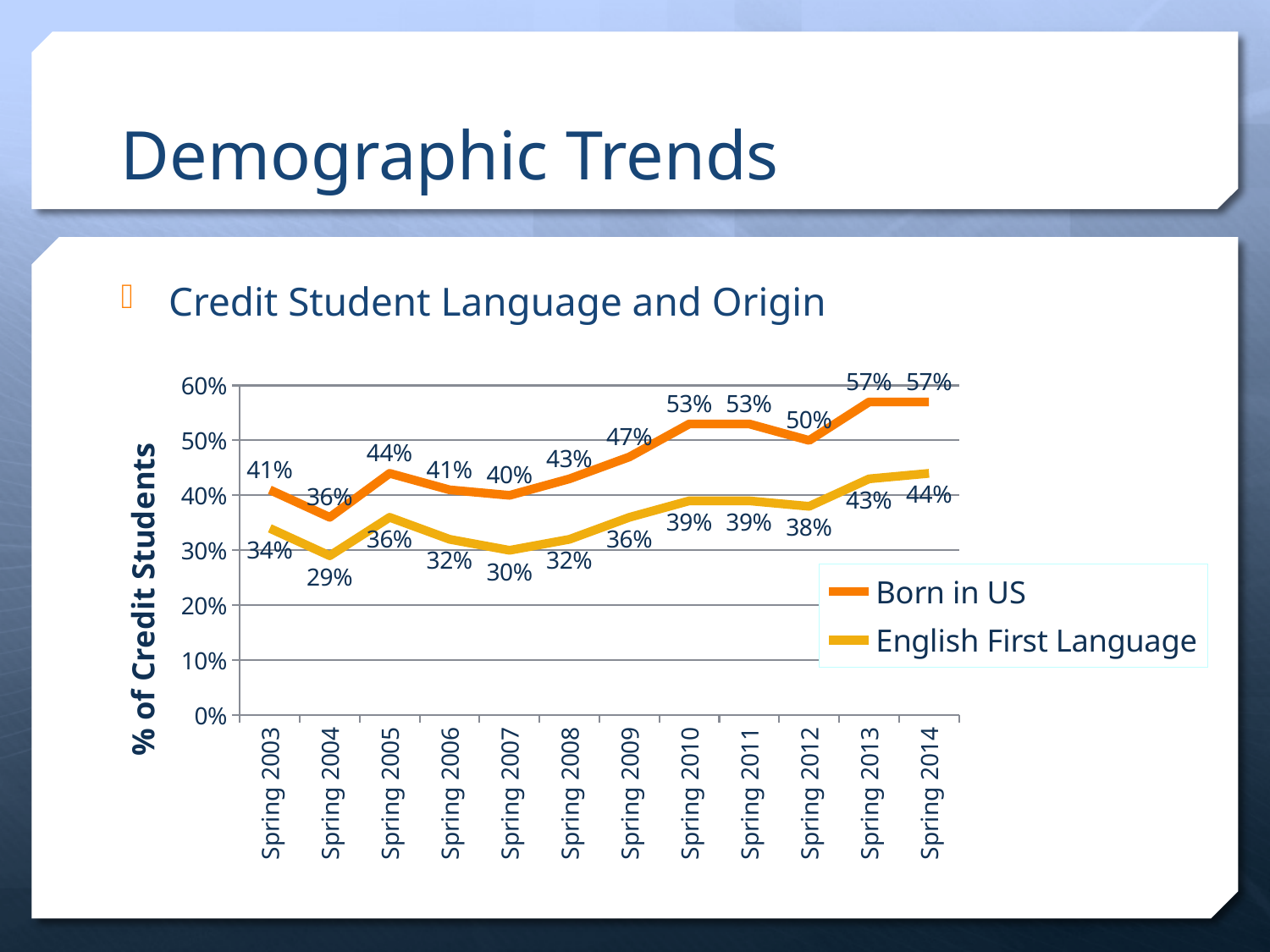
What is the label on the vertical axis of the chart? % of Credit Students In which period is the English First Language series at its highest? Spring 2014 In which period is the Born in US series at its lowest? Spring 2004 Which is larger in Spring 2007: the Born in US value or the English First Language value? Born in US How many time periods are shown on the x axis? 12 What is the Born in US value for Spring 2010? 53% What kind of chart is shown on the slide? Line chart What is the English First Language value for Spring 2004? 29% What is the English First Language value for Spring 2014? 44% What is the difference between the Born in US and English First Language values in Spring 2013? 14% How many series does the legend list? 2 Overall, does the Born in US series rise or fall from Spring 2003 to Spring 2014? Rise